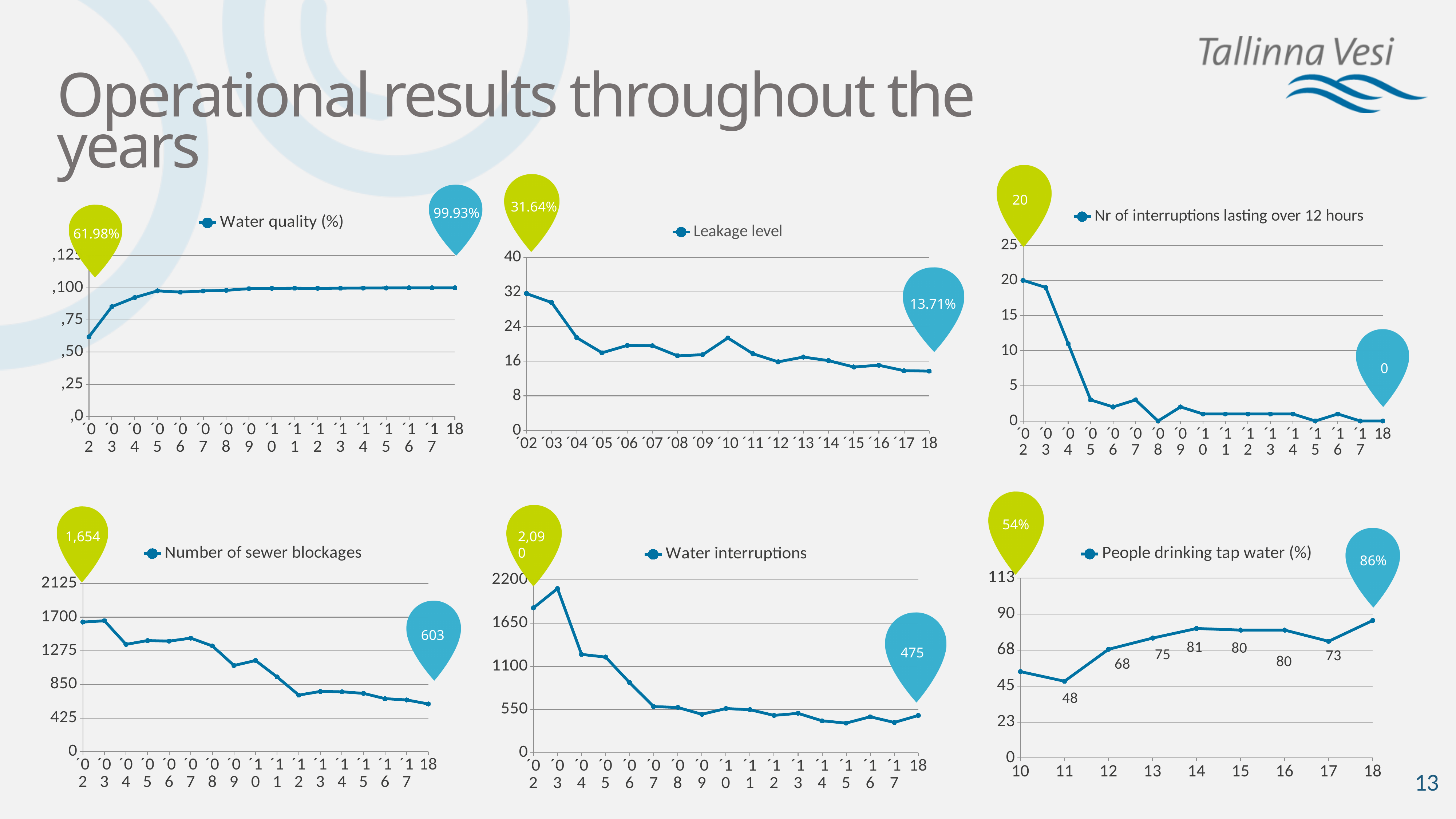
On the Leakage level chart, do the values generally rise or fall from '02 to 18? fall On the Water interruptions chart, what is the value for 18? 475 On the People drinking tap water (%) chart, which year has the lowest value? 11 On the Nr of interruptions lasting over 12 hours chart, what is the value for '02? 20 On the Water quality (%) chart, what is the value for '02? 61.98% On the Nr of interruptions lasting over 12 hours chart, what is the value for 18? 0 On the Leakage level chart, what is the value for 18? 13.71% On the People drinking tap water (%) chart, what is the value for 14? 81 On the Water quality (%) chart, what is the value for 18? 99.93% On the Water interruptions chart, is the value for '03 greater or less than 1650? greater On the People drinking tap water (%) chart, how many data points are plotted? 9